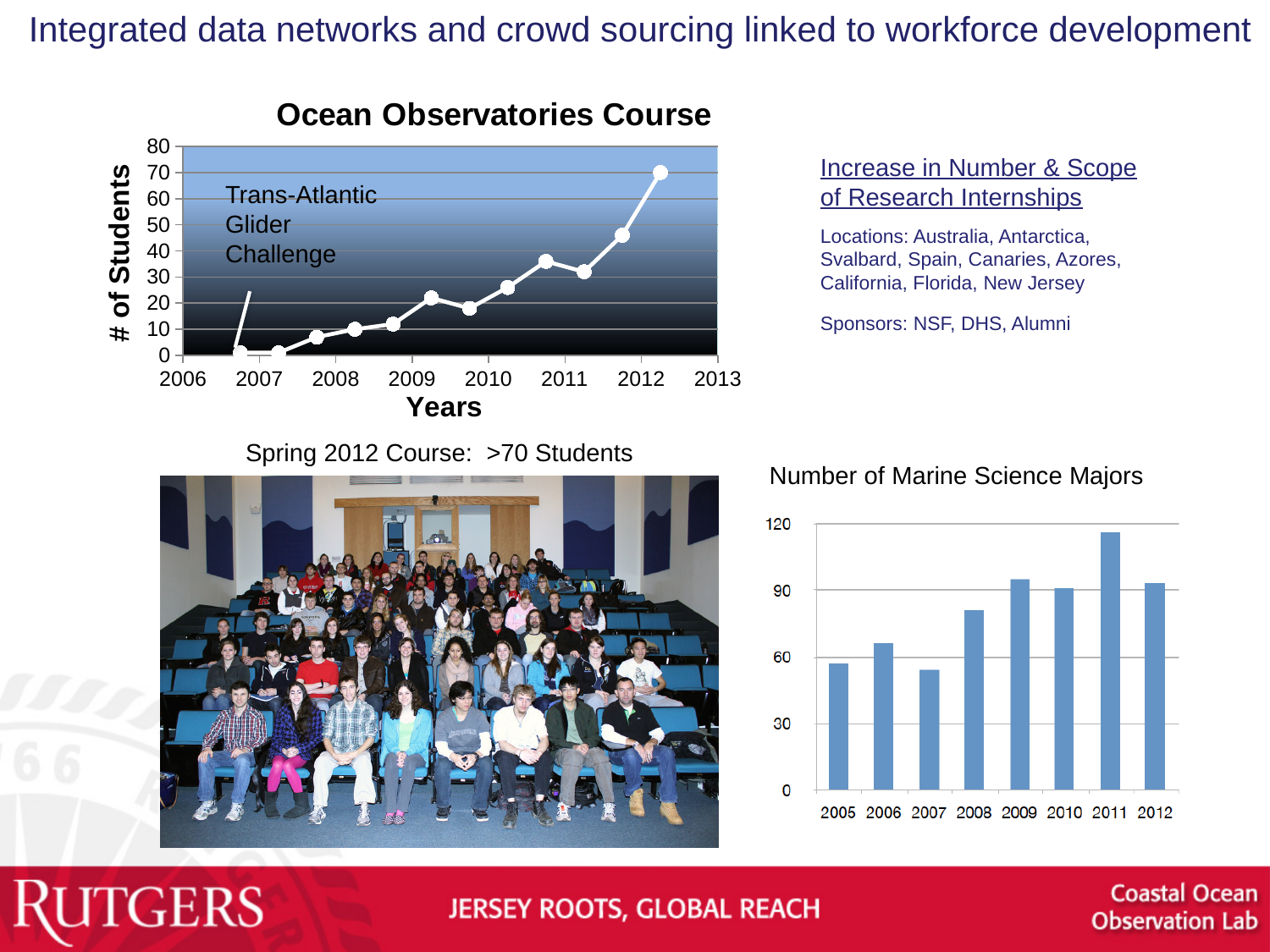
How many years are shown on the x axis of the 'Number of Marine Science Majors' chart? 8 What is the y-axis title of the 'Ocean Observatories Course' chart? # of Students In the 'Number of Marine Science Majors' chart, which year has more majors, 2011 or 2012? 2011 In the 'Number of Marine Science Majors' chart, is the value for 2008 greater or less than 90? less In the 'Ocean Observatories Course' chart, do the number of students generally rise or fall from 2007 to 2013? rise In the 'Number of Marine Science Majors' chart, is the value for 2011 greater or less than 90? greater In the 'Ocean Observatories Course' chart, is the highest point greater or less than 60 students? greater In the 'Number of Marine Science Majors' chart, which year has more majors, 2006 or 2008? 2008 What kind of chart is the 'Number of Marine Science Majors' chart? bar chart What kind of chart is the 'Ocean Observatories Course' chart? line chart In the 'Number of Marine Science Majors' chart, which year has the highest number of majors? 2011